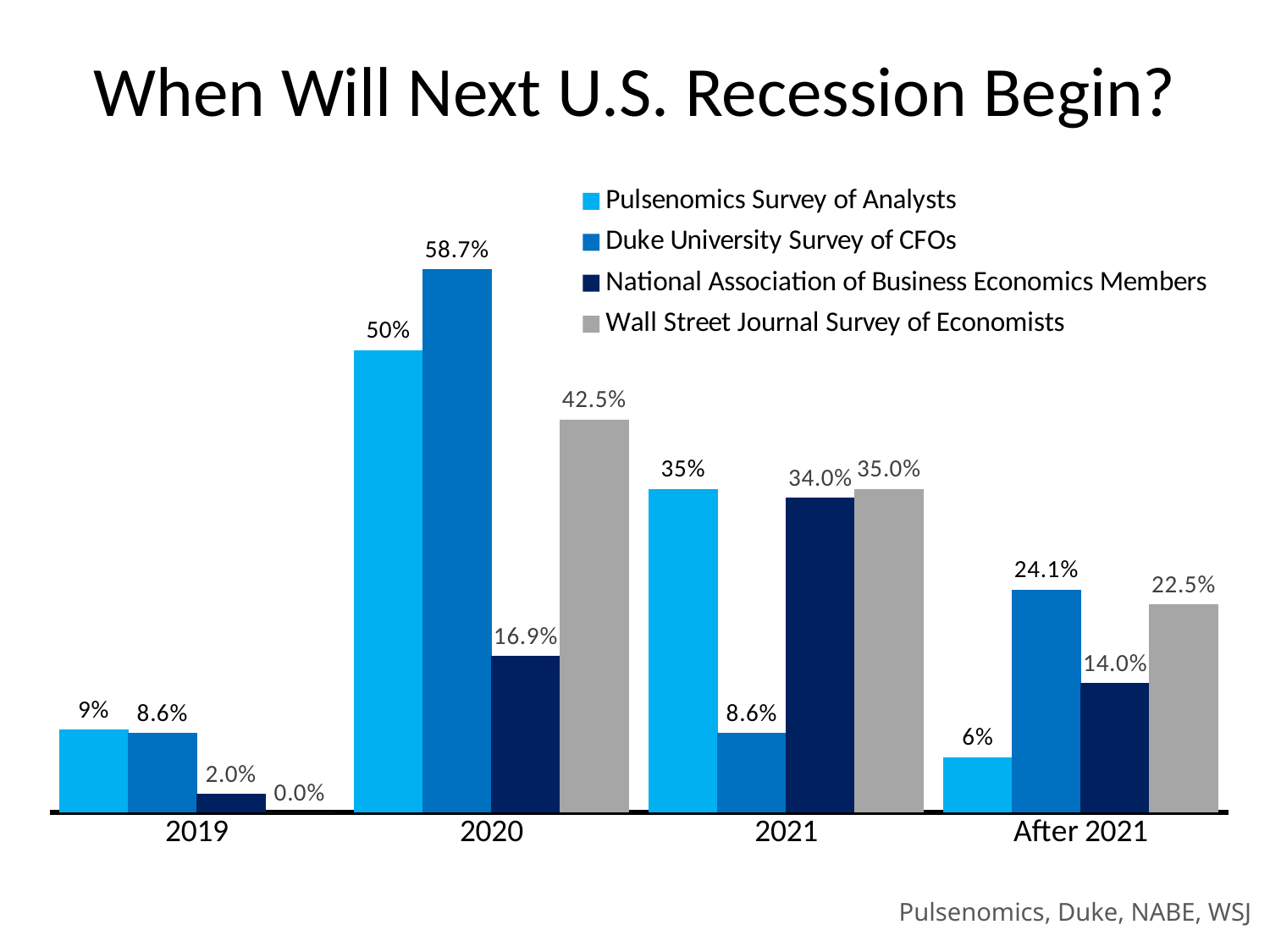
What value does the Wall Street Journal Survey of Economists show for 2019? 0.0% Which year has the highest value for the Pulsenomics Survey of Analysts? 2020 How many year categories are shown on the x axis? 4 What is the difference between the Duke University Survey of CFOs and the Pulsenomics Survey of Analysts values for 2020? 8.7% What value does the Pulsenomics Survey of Analysts show for After 2021? 6% What percentage of the Duke University Survey of CFOs expect the next recession to begin in 2020? 58.7% What value does the National Association of Business Economics Members series show for 2021? 34.0% For After 2021, which is larger: the Duke University Survey of CFOs value or the Wall Street Journal Survey of Economists value? Duke University Survey of CFOs How many series does the legend list? 4 What kind of chart is shown on the slide? Bar chart Which year has the lowest value for the Duke University Survey of CFOs? 2019 and 2021 (tied at 8.6%) What is the title of the chart? When Will Next U.S. Recession Begin?